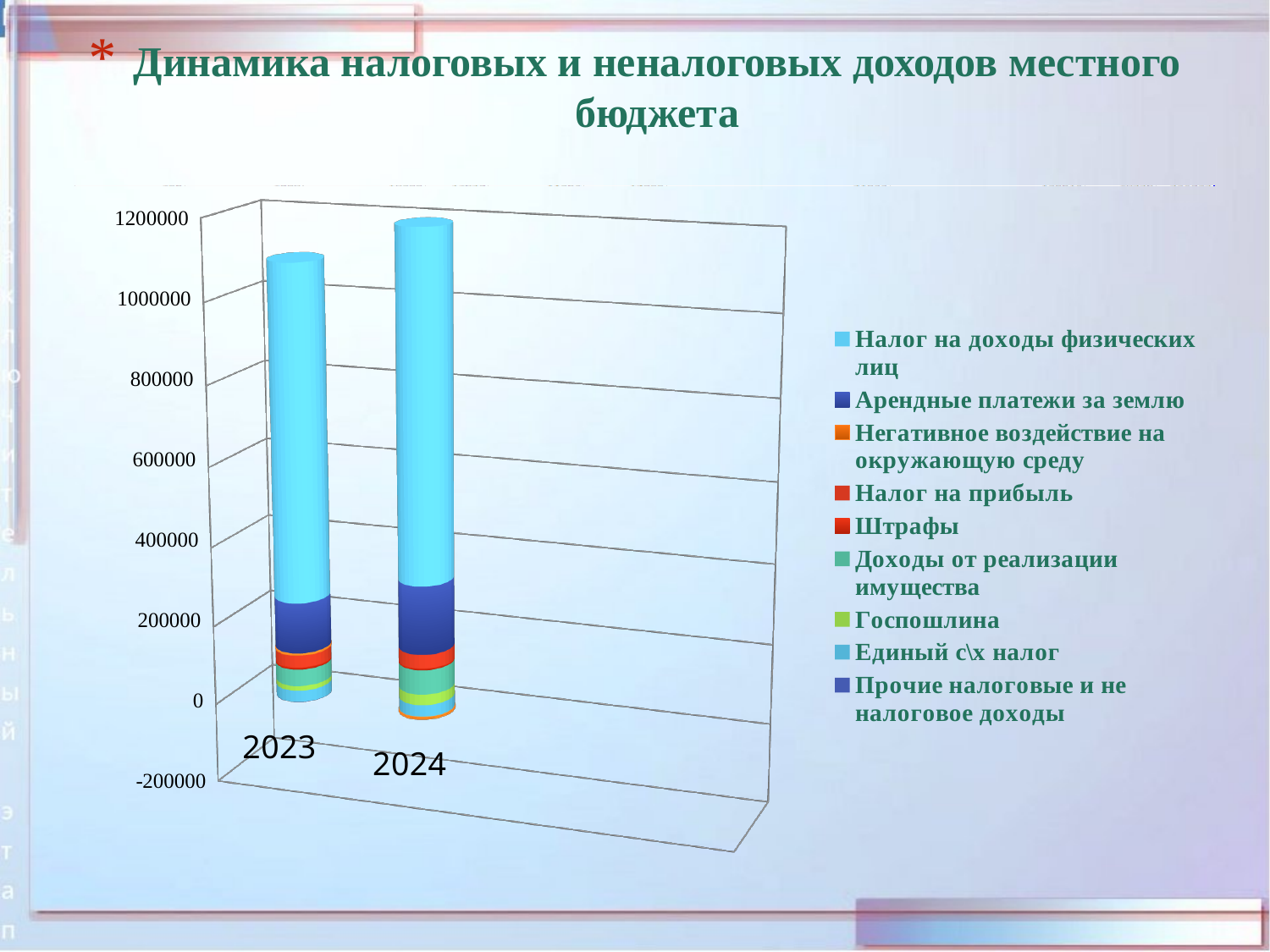
What is the first entry listed in the chart legend? Налог на доходы физических лиц What is the title of the chart on the slide? Динамика налоговых и неналоговых доходов местного бюджета Which year has the taller stacked bar, 2023 or 2024? 2024 What kind of chart is shown on the slide? Stacked bar chart Is the total of the 2024 stacked bar greater or less than 1000000? greater How many years (categories) are plotted on the x axis? 2 Does the total height of the stacked bars rise or fall from 2023 to 2024? Rises Which series forms the largest segment of the 2024 bar? Налог на доходы физических лиц What is the lowest value shown on the vertical axis? -200000 Is the total of the 2023 stacked bar greater or less than 800000? greater How many series does the legend list? 9 Which series forms the largest segment of the 2023 bar? Налог на доходы физических лиц